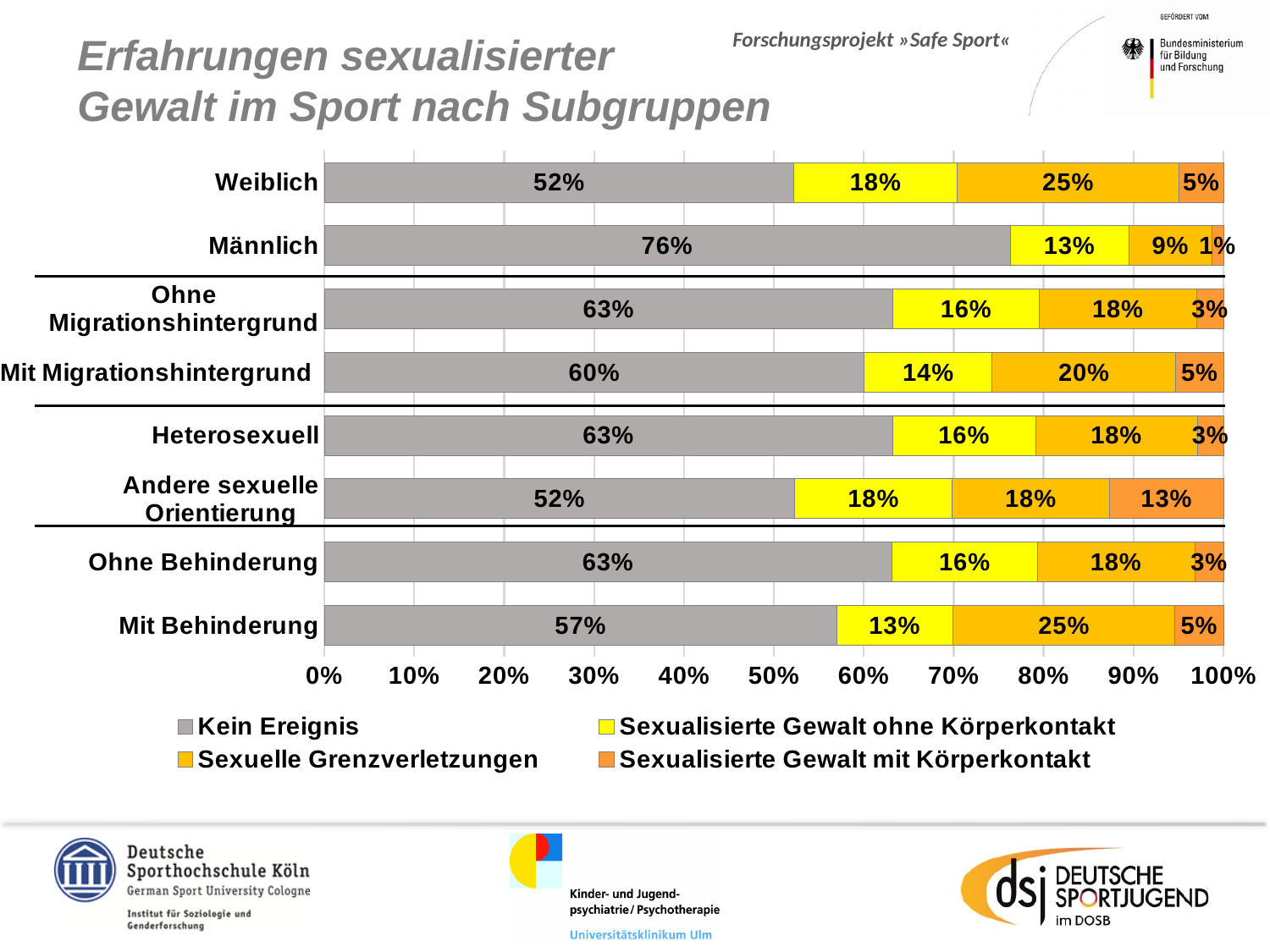
How many series does the legend list? 4 What is the value for "Sexuelle Grenzverletzungen" in the Weiblich category? 25% What is the value for "Sexualisierte Gewalt mit Körperkontakt" in the Andere sexuelle Orientierung category? 13% How many categories (subgroups) are shown on the chart? 8 What kind of chart is shown on the slide? Stacked bar chart What is the value for "Sexualisierte Gewalt ohne Körperkontakt" in the Mit Migrationshintergrund category? 14% Which is larger: the "Sexuelle Grenzverletzungen" value for Mit Behinderung or for Ohne Behinderung? Mit Behinderung What is the value for "Kein Ereignis" in the Männlich category? 76% Which category has the highest value for "Kein Ereignis"? Männlich What is the difference between the "Kein Ereignis" values for Männlich and Weiblich? 24 percentage points Which category has the highest value for "Sexualisierte Gewalt mit Körperkontakt"? Andere sexuelle Orientierung Which category has the lowest value for "Sexuelle Grenzverletzungen"? Männlich